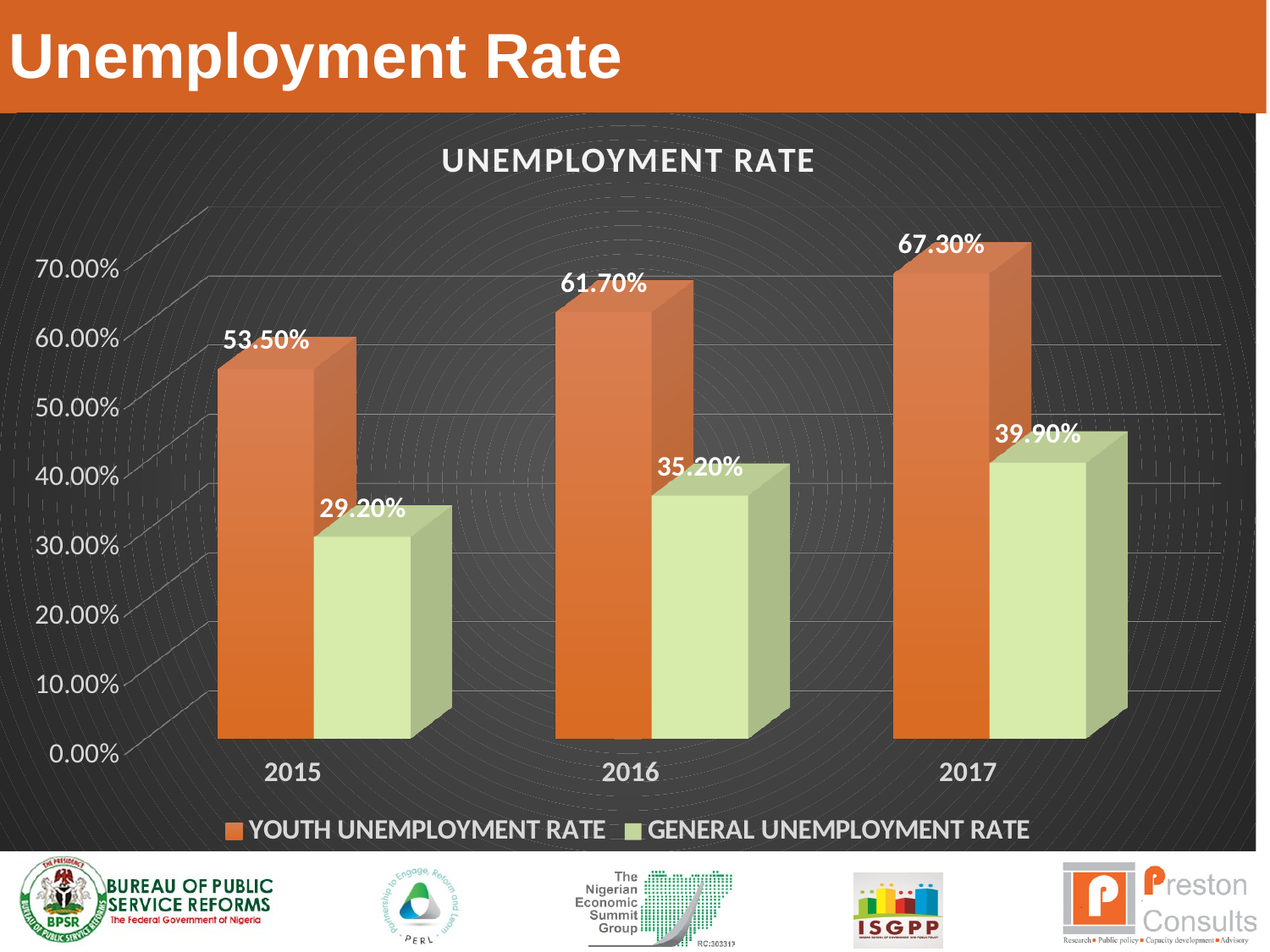
Does the general unemployment rate rise or fall from 2015 to 2017? Rise Which year has the highest youth unemployment rate? 2017 Which year has the lowest general unemployment rate? 2015 How many years are shown on the x axis? 3 What is the general unemployment rate for 2017? 39.90% What is the difference between the youth unemployment rate and the general unemployment rate in 2016? 26.50% Which is larger in 2017: the youth unemployment rate or the general unemployment rate? Youth unemployment rate How many series does the legend list? 2 What is the general unemployment rate for 2016? 35.20% By how much did the youth unemployment rate increase from 2015 to 2017? 13.80% What kind of chart is shown on the slide? Bar chart What is the youth unemployment rate for 2015? 53.50%